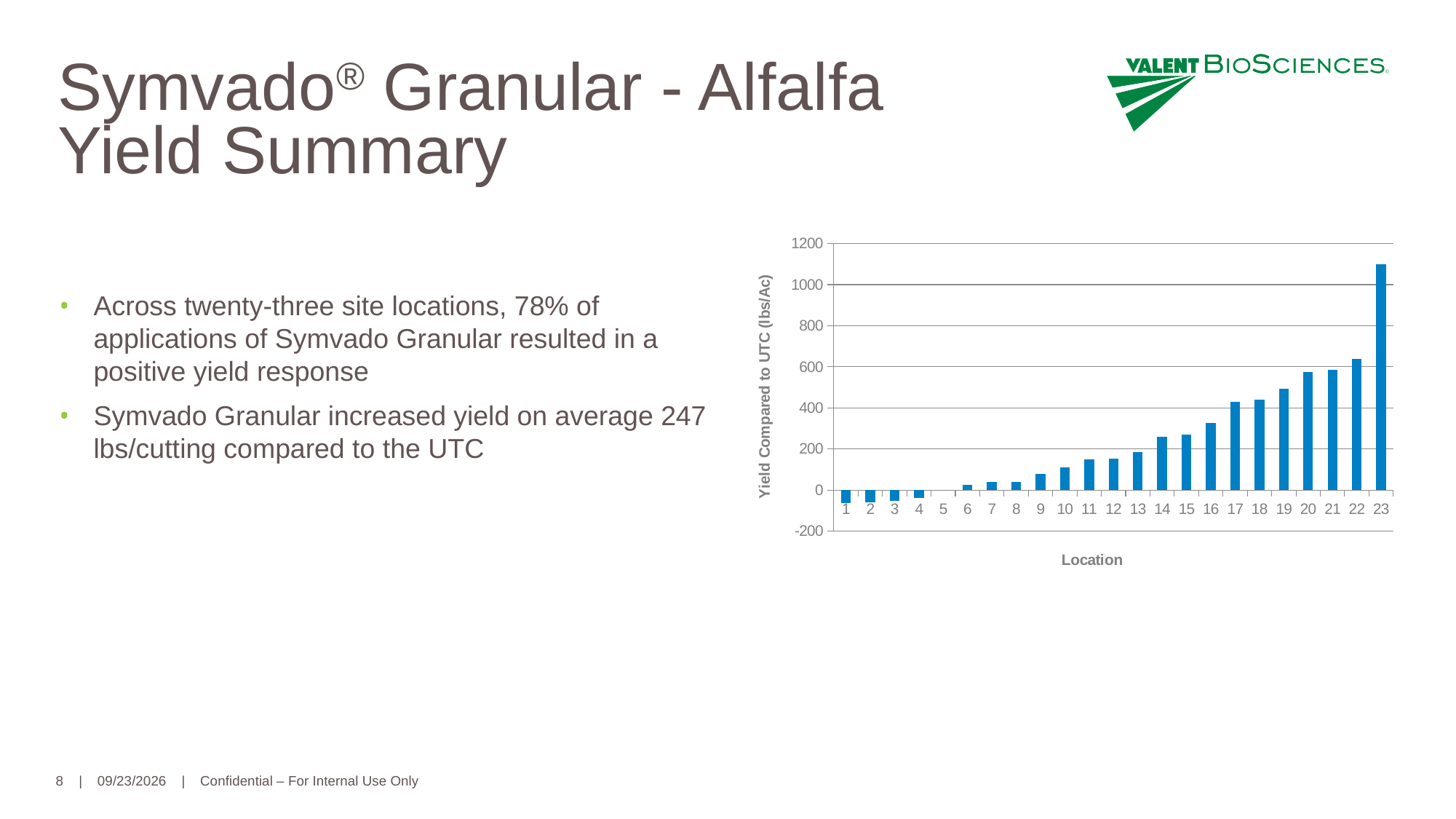
What kind of chart is shown on the slide? Bar chart Which has the larger yield compared to UTC, location 20 or location 13? Location 20 Do the bar values generally rise or fall from location 1 to location 23? Rise Which location has the highest yield compared to UTC? 23 Is the value for location 22 greater or less than 600? greater How many locations are plotted on the x axis of the chart? 23 Is the value for location 9 greater or less than 200? less Is the value for location 16 greater or less than 200? greater What is the title of the horizontal axis of the chart? Location What is the title of the vertical axis of the chart? Yield Compared to UTC (lbs/Ac)